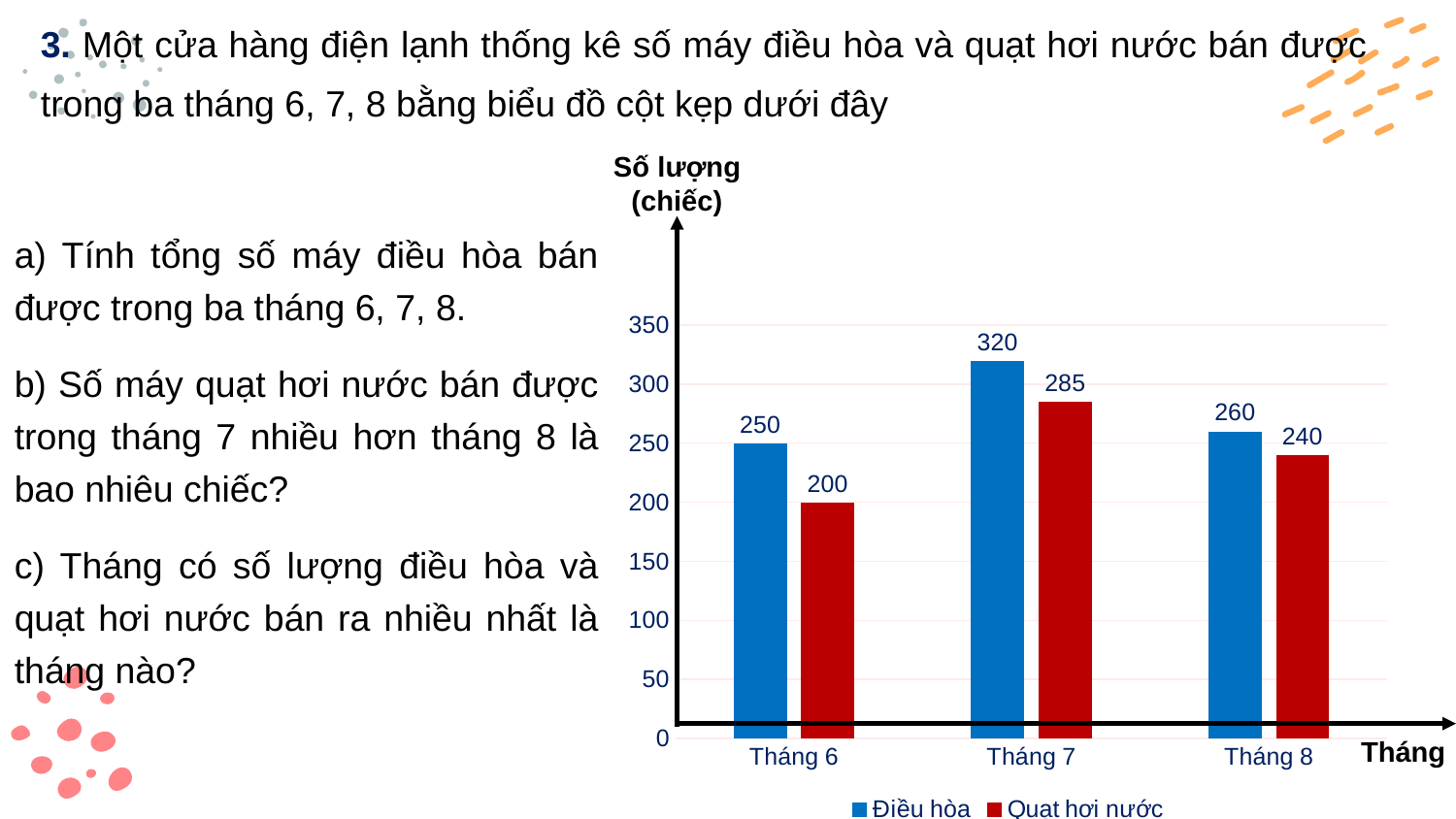
How many months are shown on the x axis? 3 How many units of Điều hòa were sold in Tháng 7? 320 What kind of chart is shown on the slide? Bar chart What is the total of Điều hòa sold across Tháng 6, Tháng 7 and Tháng 8? 830 What is the value for Điều hòa in Tháng 8? 260 What colour are the Quạt hơi nước bars? Red Which is larger in Tháng 8: Điều hòa or Quạt hơi nước? Điều hòa How many series does the legend list? 2 Which month has the lowest value for Quạt hơi nước? Tháng 6 What is the value for Quạt hơi nước in Tháng 6? 200 Which month has the highest value for Điều hòa? Tháng 7 What is the difference between Quạt hơi nước sold in Tháng 7 and Tháng 8? 45